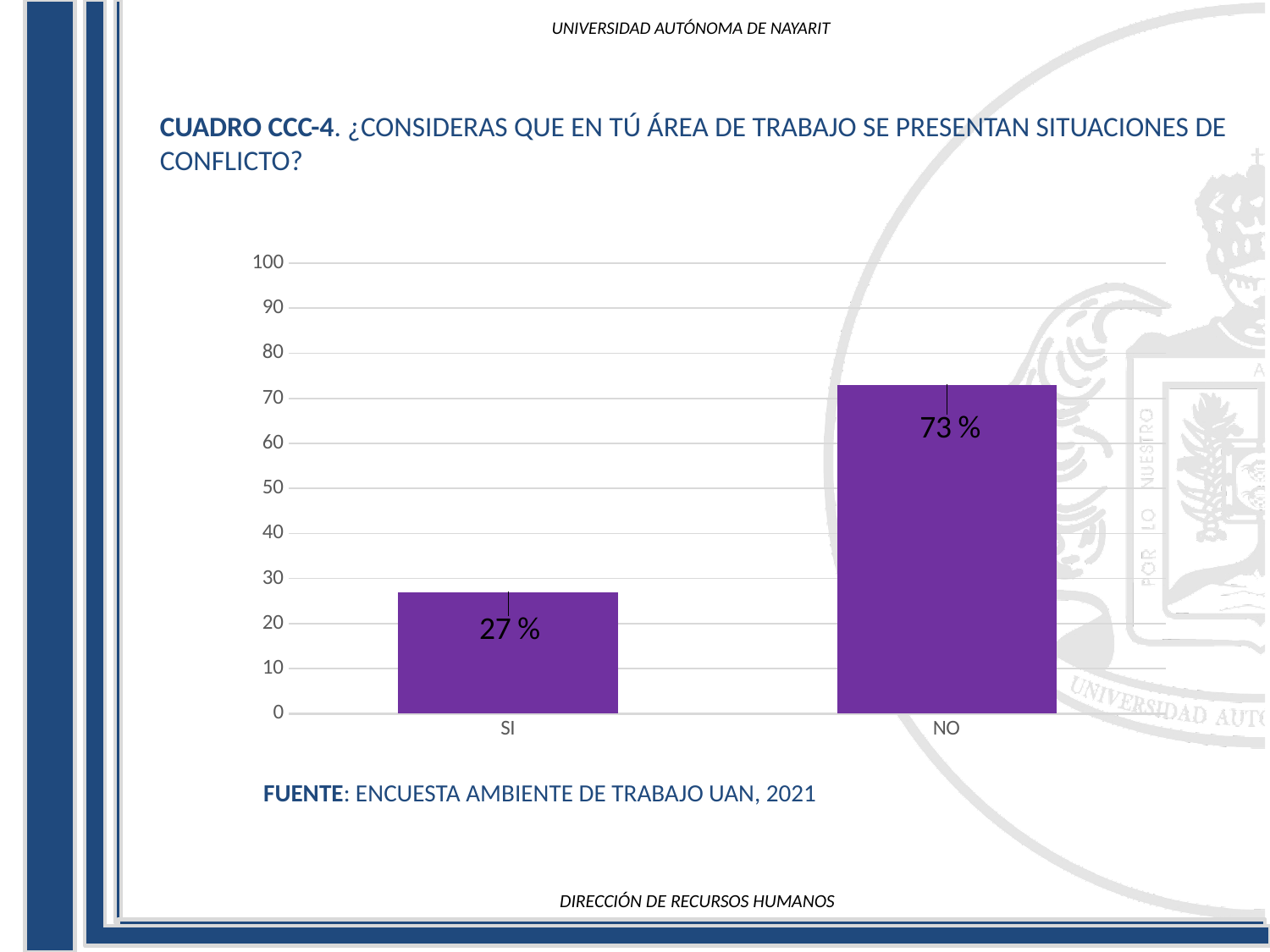
What is the difference between the values for NO and SI? 46 % What is the highest value shown on the y axis? 100 What kind of chart is shown on the slide? bar chart Which category has the highest value? NO Is the value for SI greater or less than 30? less What is the value for NO? 73 % Is the value for NO greater or less than 70? greater What is the source cited below the chart? ENCUESTA AMBIENTE DE TRABAJO UAN, 2021 Which category has the lowest value? SI Which is larger, the value for SI or the value for NO? NO How many categories are shown on the x axis? 2 What is the value for SI? 27 %